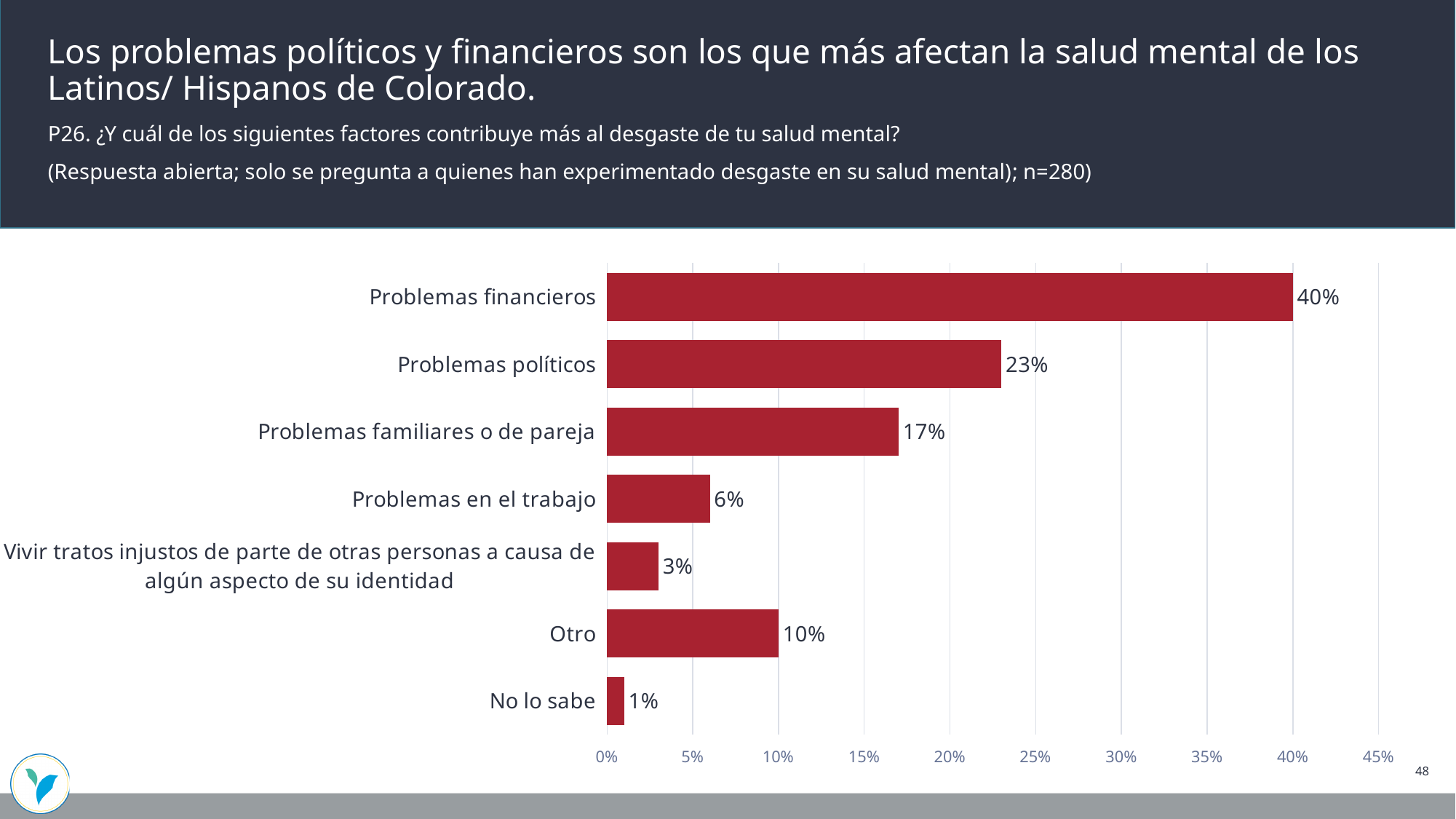
What percentage is shown for Problemas familiares o de pareja? 17% What is the highest value shown on the x axis? 45% What percentage is shown for Problemas políticos? 23% Which category has the lowest value? No lo sabe What percentage is shown for Otro? 10% Which is larger, Otro or Problemas en el trabajo? Otro What kind of chart is shown on the slide? Bar chart What is the difference between Problemas en el trabajo and Vivir tratos injustos de parte de otras personas a causa de algún aspecto de su identidad? 3% What is the difference between Problemas financieros and Problemas políticos? 17% What percentage is shown for Problemas financieros? 40% Which category has the highest value? Problemas financieros How many categories are shown in the chart? 7